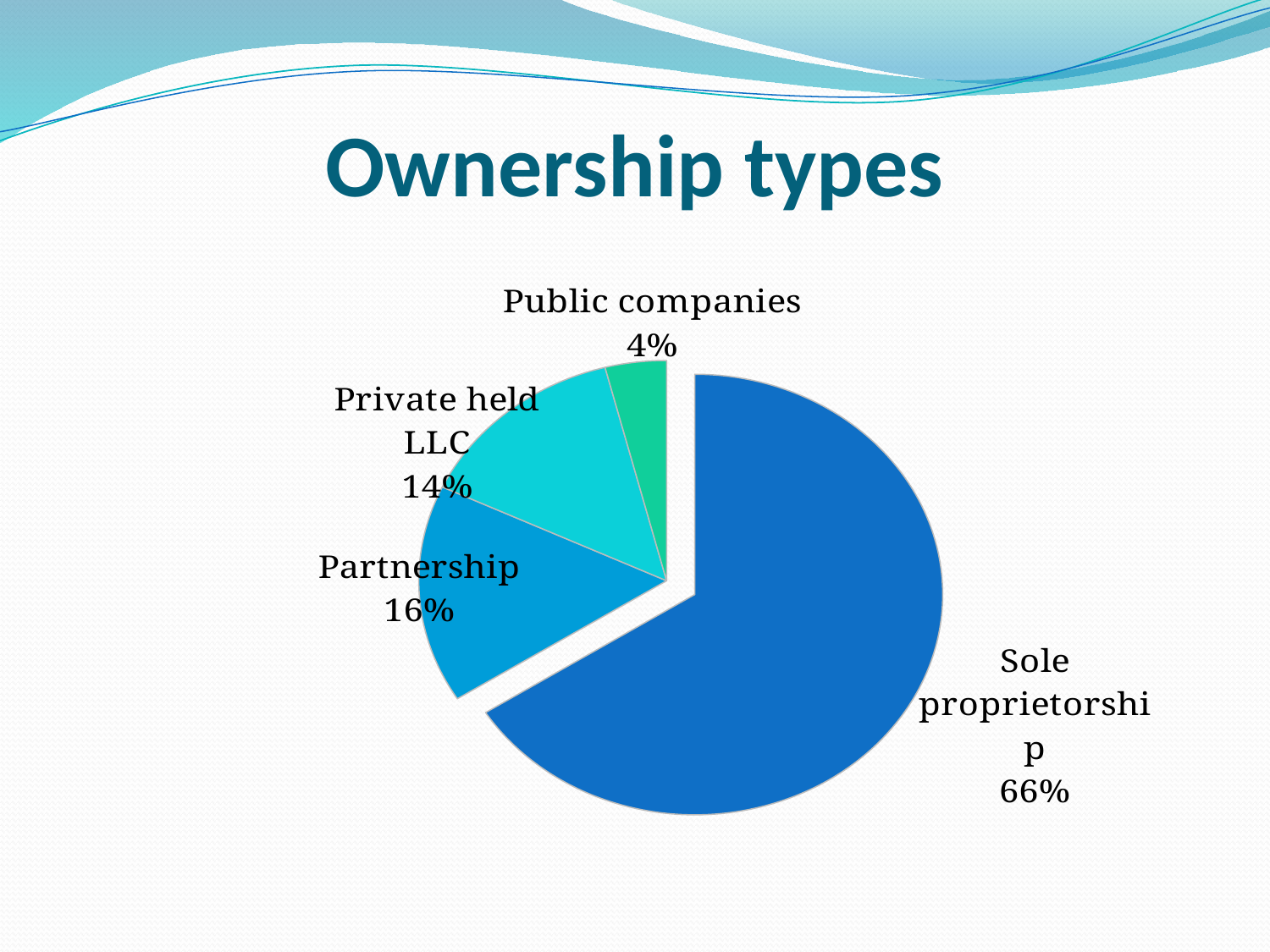
What share of the pie does Partnership hold? 16% Which ownership type has the largest slice of the pie? Sole proprietorship Which ownership type has the smallest slice of the pie? Public companies How many ownership types are shown in the pie chart? 4 What is the difference in percentage points between Sole proprietorship and Partnership? 50 What share of the pie does Private held LLC hold? 14% What is the title of the slide containing the chart? Ownership types What is the difference in percentage points between Partnership and Private held LLC? 2 Which is larger, the share for Partnership or the share for Public companies? Partnership What kind of chart is shown on the slide? Pie chart What share of the pie does Public companies hold? 4%